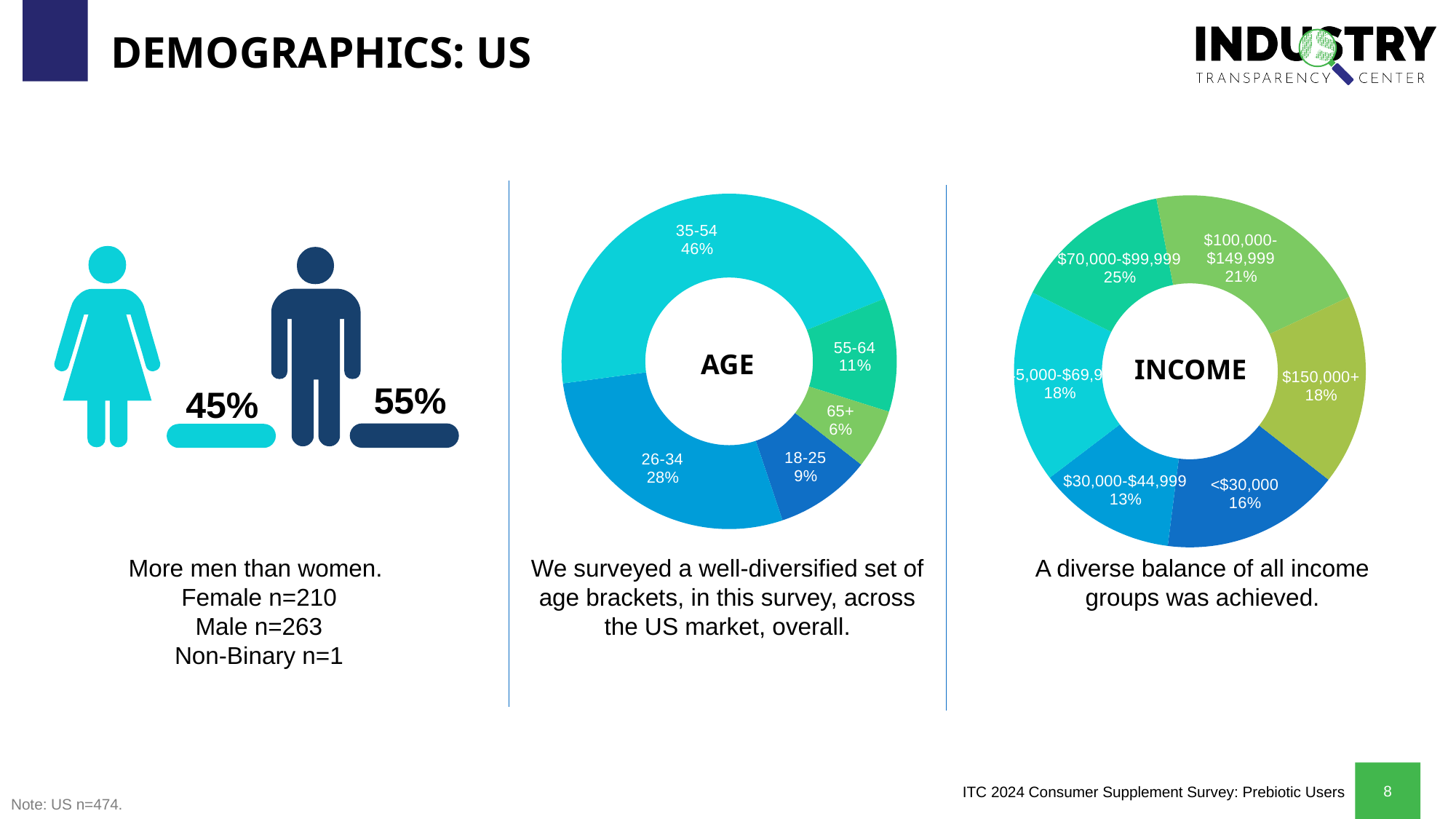
In the INCOME chart, which income group has the smallest share? $30,000-$44,999 In the AGE chart, how many percentage points larger is the 26-34 group than the 18-25 group? 19 percentage points How many income groups are shown in the INCOME chart? 6 In the AGE chart, which age group has the largest share? 35-54 In the INCOME chart, what share is the $70,000-$99,999 group? 25% In the AGE chart, what share is the 55-64 age group? 11% How many age groups are shown in the AGE chart? 5 What kind of chart is the AGE chart? doughnut chart In the AGE chart, which age group has the smallest share? 65+ In the INCOME chart, which is larger: <$30,000 or $30,000-$44,999? <$30,000 In the AGE chart, what share is the 35-54 age group? 46%